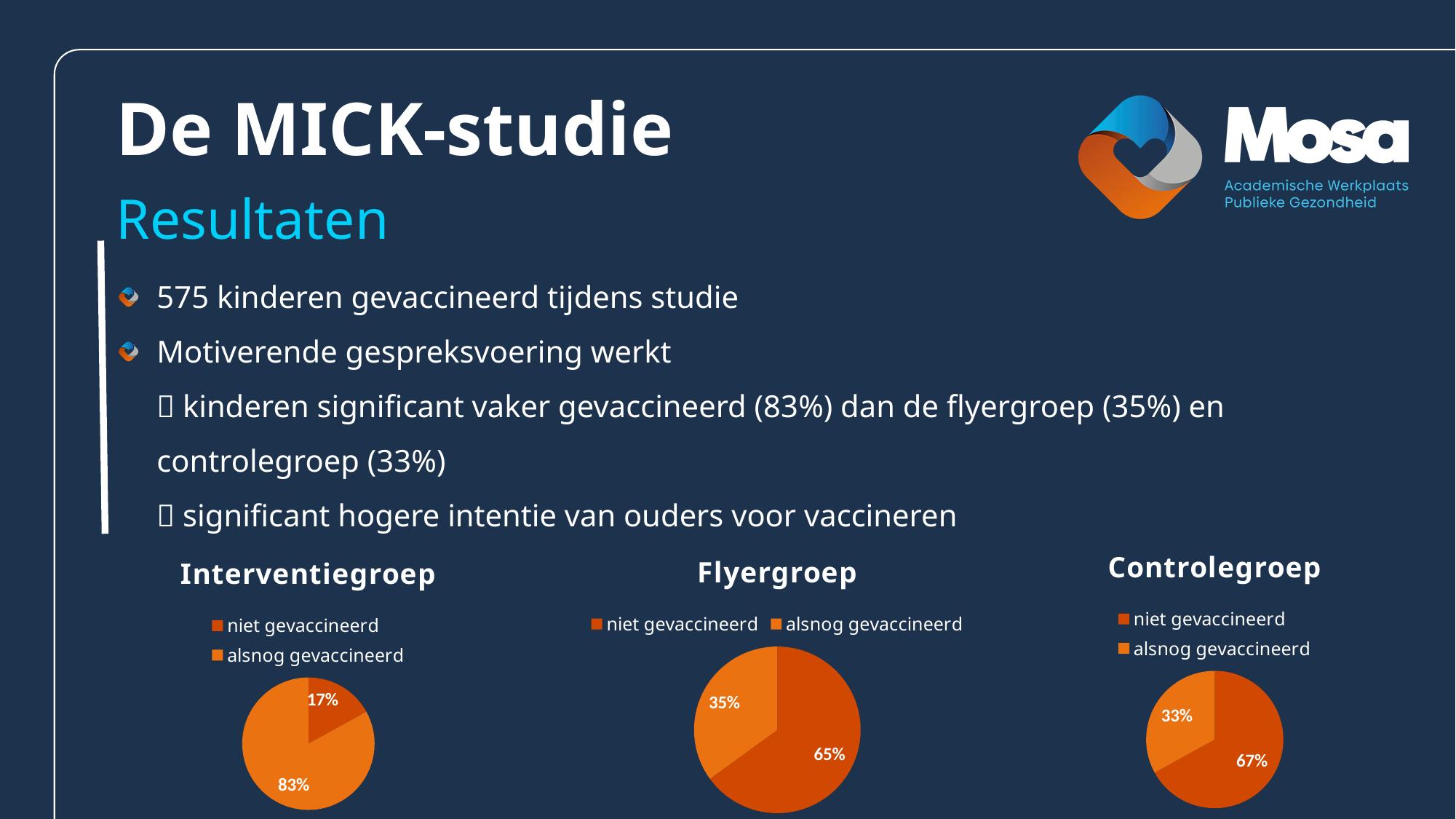
In the Controlegroep chart, what share is labelled 'alsnog gevaccineerd'? 33% In the Controlegroep chart, which slice is the largest? niet gevaccineerd In the Flyergroep chart, what share is labelled 'niet gevaccineerd'? 65% How many entries does the legend of the Controlegroep chart list? 2 In the Interventiegroep chart, what share is labelled 'alsnog gevaccineerd'? 83% In the Controlegroep chart, what share is labelled 'niet gevaccineerd'? 67% What is the difference between the 'niet gevaccineerd' share in the Flyergroep chart and the 'niet gevaccineerd' share in the Interventiegroep chart? 48% In the Interventiegroep chart, what share is labelled 'niet gevaccineerd'? 17% In the Flyergroep chart, what share is labelled 'alsnog gevaccineerd'? 35% How many slices does the Flyergroep pie chart have? 2 In the Interventiegroep chart, which slice is larger: 'niet gevaccineerd' or 'alsnog gevaccineerd'? alsnog gevaccineerd What kind of chart is the Interventiegroep chart? pie chart